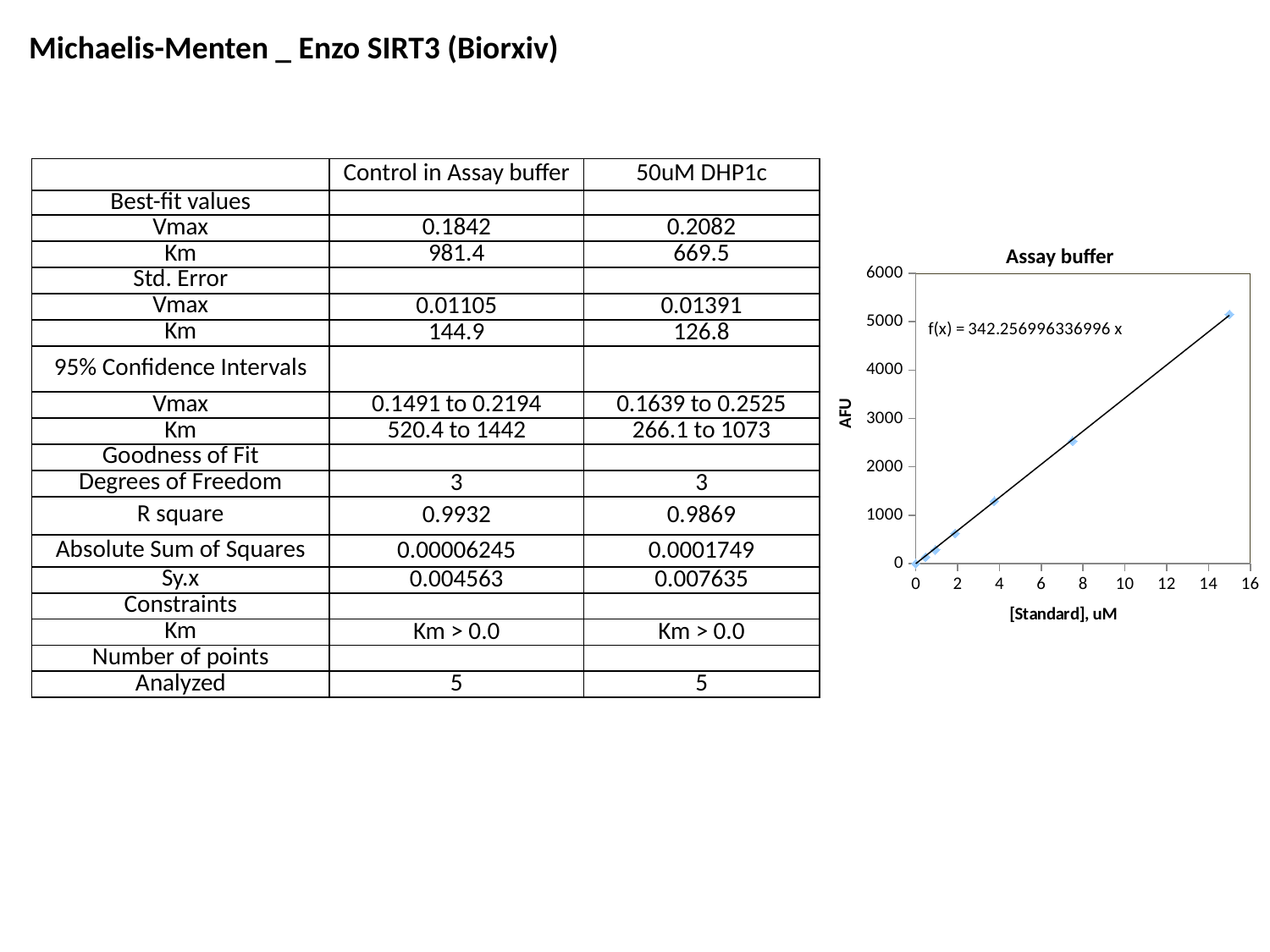
What trendline equation is printed on the "Assay buffer" chart? f(x) = 342.256996336996 x What is the title of the chart on the slide? Assay buffer What is the highest tick value shown on the y axis of the "Assay buffer" chart? 6000 In the "Assay buffer" chart, is the AFU value for the point near 7.5 uM greater or less than 2000? greater In the "Assay buffer" chart, do the AFU values rise or fall as [Standard], uM increases? rise In the "Assay buffer" chart, what is the label of the x axis? [Standard], uM In the "Assay buffer" chart, is the AFU value for the point at about 15 uM greater or less than 4000? greater In the "Assay buffer" chart, is the AFU value for the point near 7.5 uM greater or less than 3000? less In the "Assay buffer" chart, what is the label of the y axis? AFU In the "Assay buffer" chart, which point has the highest AFU value: the one near 15 uM or the one near 7.5 uM? the one near 15 uM What kind of chart is the "Assay buffer" chart? scatter chart